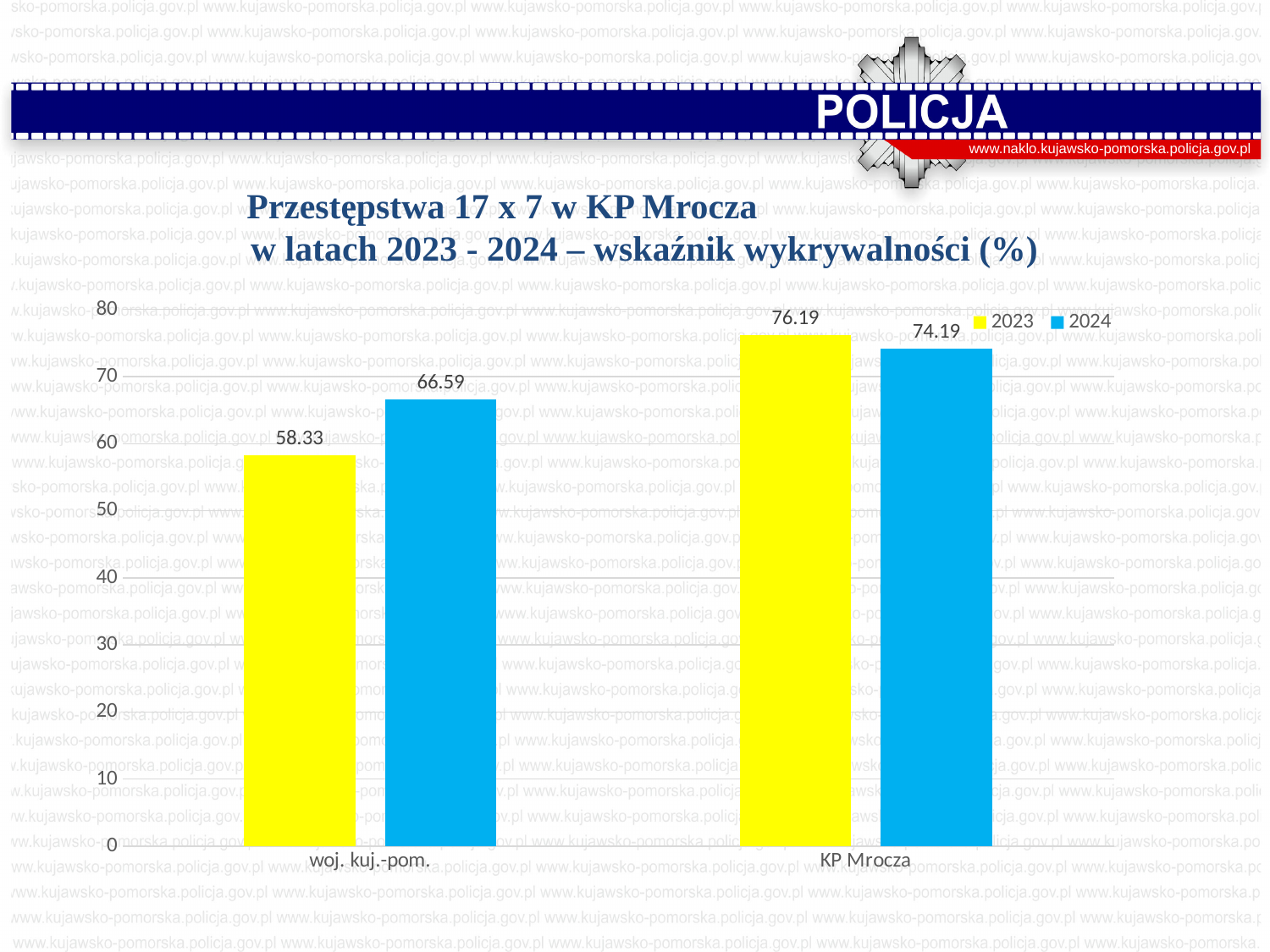
Which category has the highest 2023 value? KP Mrocza Which category has the lowest 2024 value? woj. kuj.-pom. How many series does the legend list? 2 What is the difference between the 2023 and 2024 values for KP Mrocza? 2.00 What is the 2023 value for KP Mrocza? 76.19 What is the 2024 value for KP Mrocza? 74.19 What is the 2023 value for woj. kuj.-pom.? 58.33 What is the 2024 value for woj. kuj.-pom.? 66.59 How many categories are shown on the x axis? 2 What kind of chart is shown on the slide? bar chart For KP Mrocza, which year has the larger value, 2023 or 2024? 2023 What is the difference between the 2024 and 2023 values for woj. kuj.-pom.? 8.26